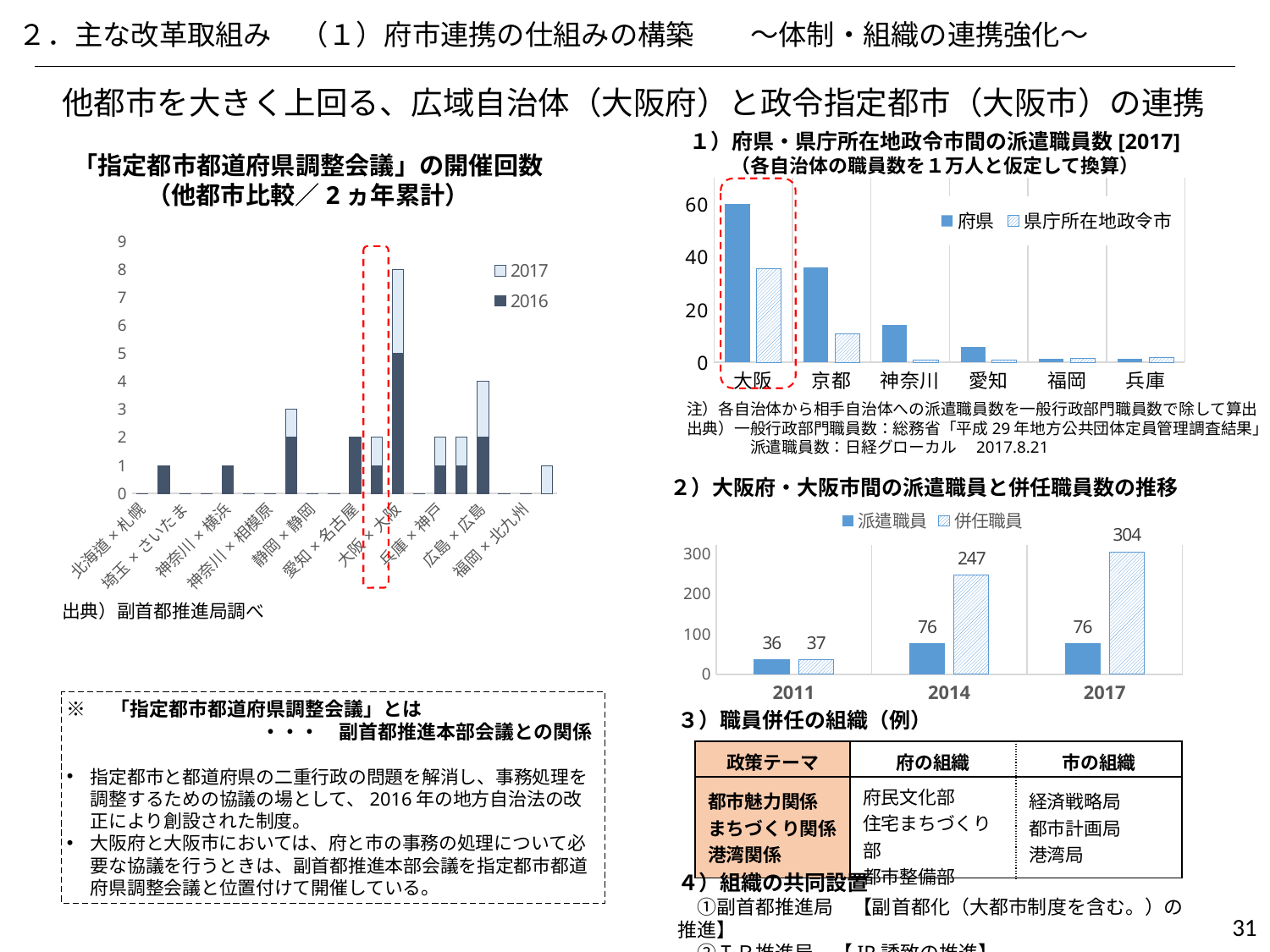
In the chart titled 「大阪府・大阪市間の派遣職員と併任職員数の推移」, does the value for 併任職員 rise or fall from 2011 to 2017? rise In the chart titled 「大阪府・大阪市間の派遣職員と併任職員数の推移」, what is the value for 併任職員 in 2017? 304 What kind of chart is the chart titled 「指定都市都道府県調整会議」の開催回数? stacked bar chart In the chart titled 「大阪府・大阪市間の派遣職員と併任職員数の推移」, what is the difference between 併任職員 and 派遣職員 in 2017? 228 In the chart titled 「指定都市都道府県調整会議」の開催回数, which category has the highest total? 大阪×大阪 In the chart titled 「府県・県庁所在地政令市間の派遣職員数 [2017]」, how many categories are shown on the x axis? 6 In the chart titled 「大阪府・大阪市間の派遣職員と併任職員数の推移」, how many years are shown on the x axis? 3 In the chart titled 「府県・県庁所在地政令市間の派遣職員数 [2017]」, is the value for 府県 in 京都 greater or less than 40? less In the chart titled 「府県・県庁所在地政令市間の派遣職員数 [2017]」, which category has the highest value for 府県? 大阪 In the chart titled 「府県・県庁所在地政令市間の派遣職員数 [2017]」, how many series does the legend list? 2 In the chart titled 「大阪府・大阪市間の派遣職員と併任職員数の推移」, which year has the highest value for 併任職員? 2017 In the chart titled 「大阪府・大阪市間の派遣職員と併任職員数の推移」, what is the value for 派遣職員 in 2014? 76